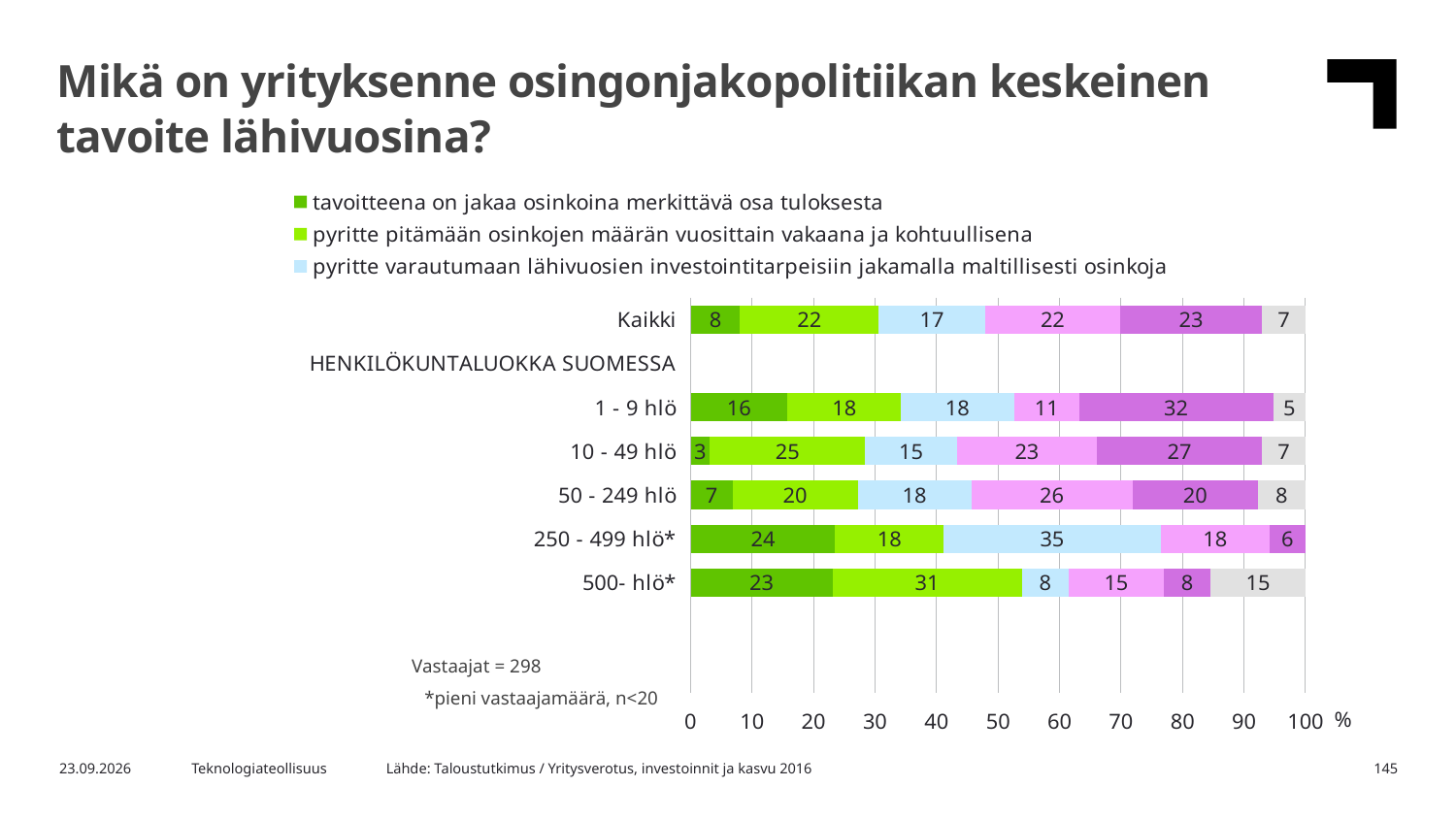
What is the value for 'pyritte varautumaan lähivuosien investointitarpeisiin jakamalla maltillisesti osinkoja' for 250 - 499 hlö*? 35 Which category has the lowest value for 'pyritte varautumaan lähivuosien investointitarpeisiin jakamalla maltillisesti osinkoja'? 500- hlö* Which category has the lowest value for 'tavoitteena on jakaa osinkoina merkittävä osa tuloksesta'? 10 - 49 hlö What is the value for 'tavoitteena on jakaa osinkoina merkittävä osa tuloksesta' in the Kaikki bar? 8 Which category has the highest value for 'pyritte pitämään osinkojen määrän vuosittain vakaana ja kohtuullisena'? 500- hlö* How many categories have bars plotted in the chart? 6 In the Kaikki bar, what is the difference between the value for 'pyritte pitämään osinkojen määrän vuosittain vakaana ja kohtuullisena' and the value for 'tavoitteena on jakaa osinkoina merkittävä osa tuloksesta'? 14 What is the value for 'pyritte pitämään osinkojen määrän vuosittain vakaana ja kohtuullisena' for 10 - 49 hlö? 25 Which has the larger value for 'tavoitteena on jakaa osinkoina merkittävä osa tuloksesta': 1 - 9 hlö or 10 - 49 hlö? 1 - 9 hlö How many series does the legend list? 3 What is the title of the chart on the slide? Mikä on yrityksenne osingonjakopolitiikan keskeinen tavoite lähivuosina? What kind of chart is shown on the slide? bar chart